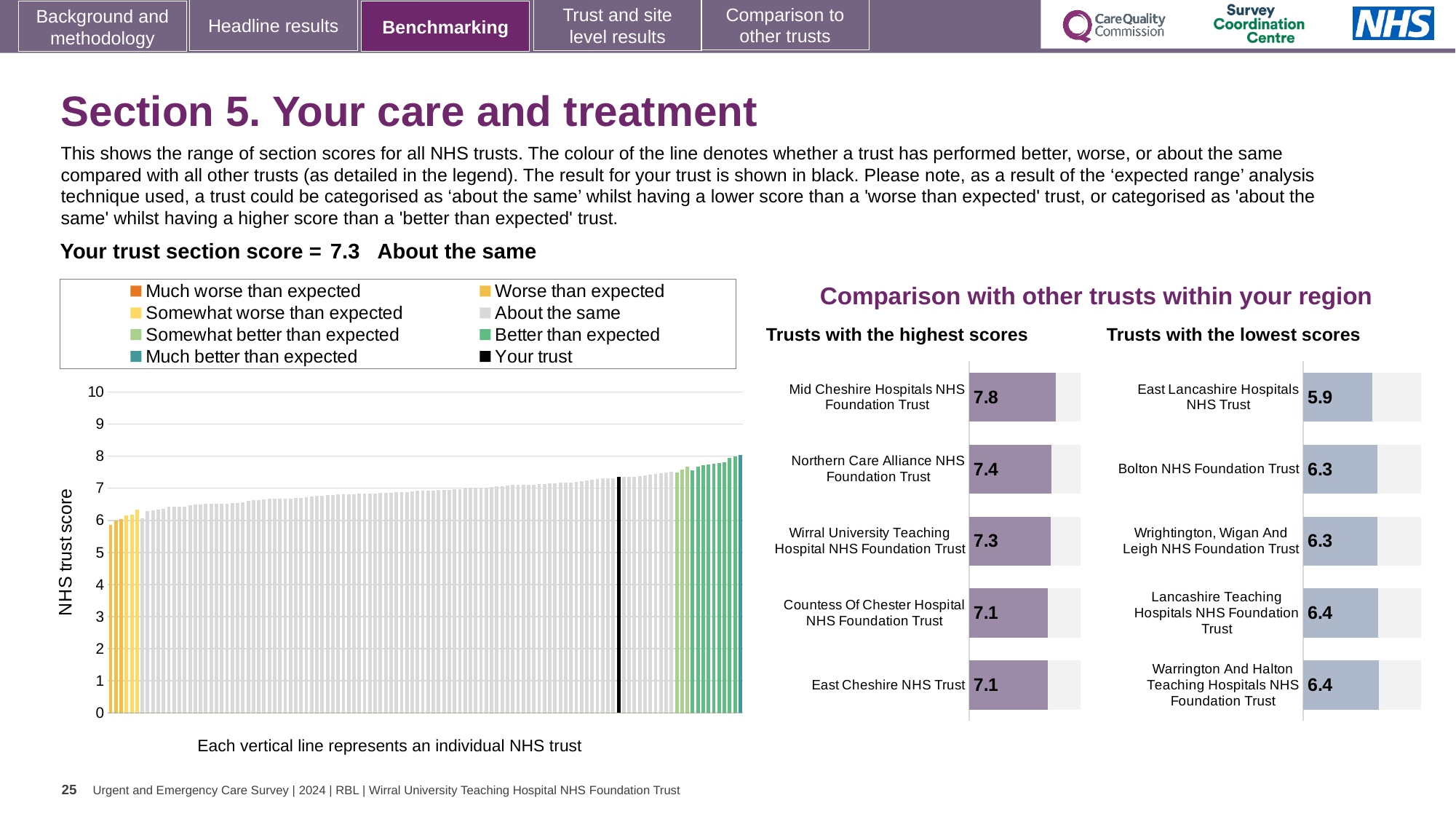
In the 'Trusts with the highest scores' chart, which has the larger score: Northern Care Alliance NHS Foundation Trust or Countess Of Chester Hospital NHS Foundation Trust? Northern Care Alliance NHS Foundation Trust In the main 'NHS trust score' chart on the left, do the values rise or fall from left to right along the x axis? Rise In the 'Trusts with the lowest scores' chart, what is the score for East Lancashire Hospitals NHS Trust? 5.9 How many trusts are listed in the 'Trusts with the highest scores' chart? 5 In the 'Trusts with the highest scores' chart, what is the score for Mid Cheshire Hospitals NHS Foundation Trust? 7.8 In the 'Trusts with the lowest scores' chart, what is the difference between the scores of Warrington And Halton Teaching Hospitals NHS Foundation Trust and East Lancashire Hospitals NHS Trust? 0.5 In the 'Trusts with the highest scores' chart, which trust has the highest score? Mid Cheshire Hospitals NHS Foundation Trust What kind of chart is the 'Trusts with the lowest scores' chart? Bar chart In the 'Trusts with the lowest scores' chart, which trust has the lowest score? East Lancashire Hospitals NHS Trust In the 'Trusts with the highest scores' chart, what is the difference between the scores of Mid Cheshire Hospitals NHS Foundation Trust and Wirral University Teaching Hospital NHS Foundation Trust? 0.5 How many entries does the legend of the main 'NHS trust score' chart on the left list? 8 What is the y-axis label of the main chart on the left of the slide? NHS trust score